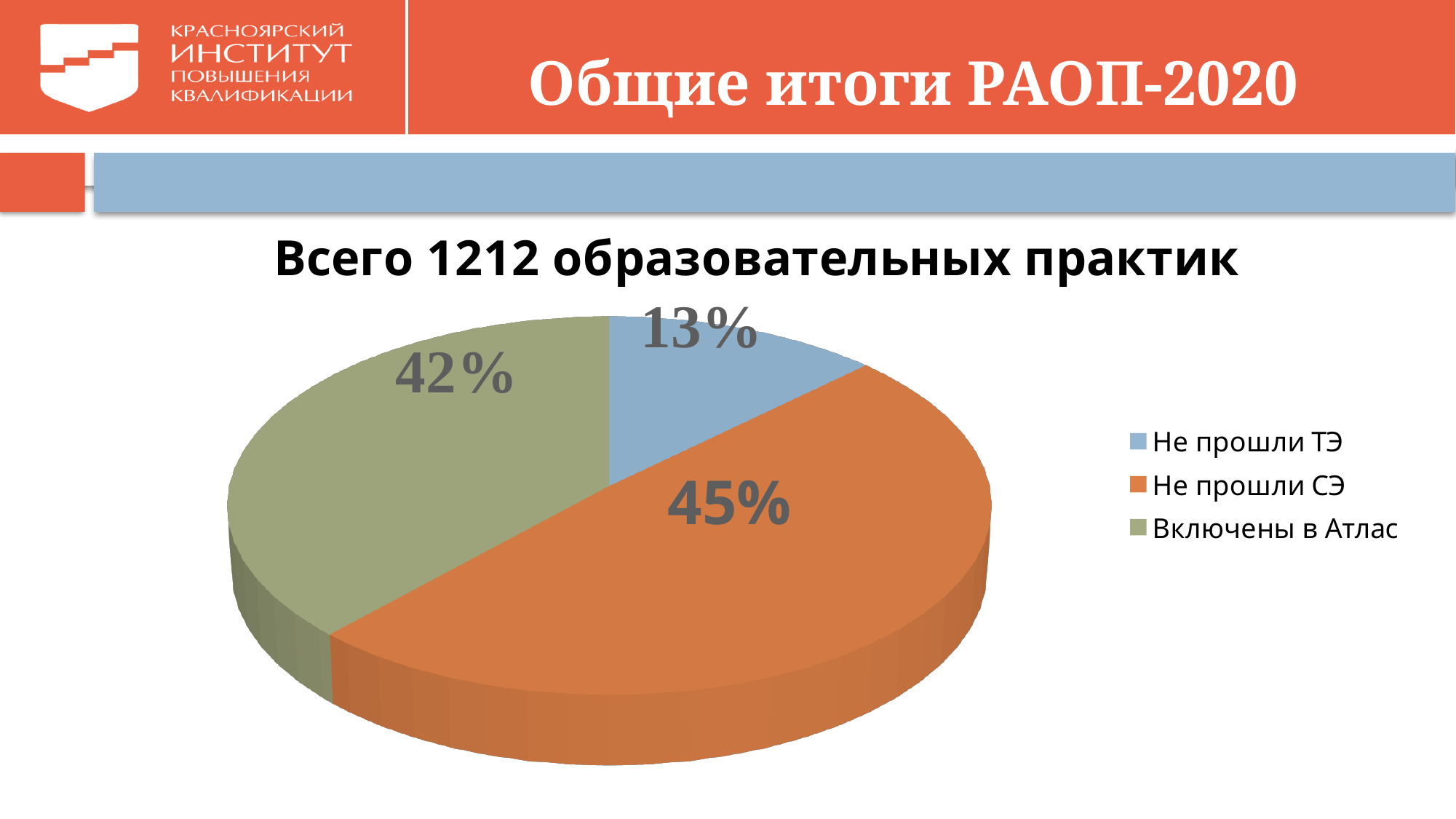
What share of the pie does "Не прошли ТЭ" represent? 13% What share of the pie does "Включены в Атлас" represent? 42% What share of the pie does "Не прошли СЭ" represent? 45% What is the title of the chart? Всего 1212 образовательных практик What colour is the slice for "Включены в Атлас"? Green Which category has the smallest slice of the pie? Не прошли ТЭ How many categories does the pie chart show? 3 Which is larger: the share for "Не прошли СЭ" or the share for "Не прошли ТЭ"? Не прошли СЭ What is the difference in percentage points between "Не прошли СЭ" and "Включены в Атлас"? 3 What is the difference in percentage points between "Включены в Атлас" and "Не прошли ТЭ"? 29 Which category has the largest slice of the pie? Не прошли СЭ What kind of chart is shown on the slide? Pie chart